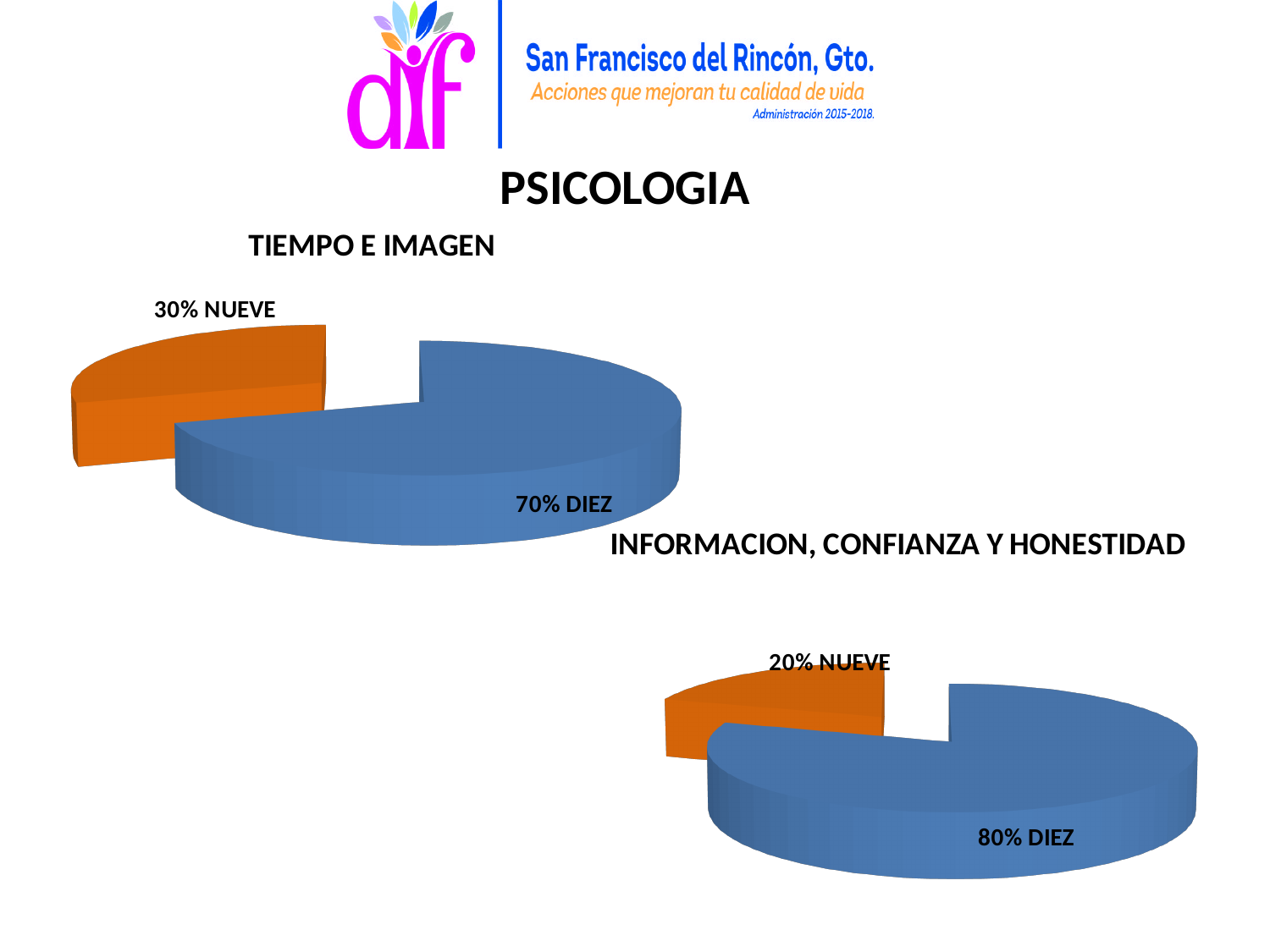
In the 'TIEMPO E IMAGEN' chart, what share of the pie is labelled DIEZ? 70% In the 'INFORMACION, CONFIANZA Y HONESTIDAD' chart, what share of the pie is labelled NUEVE? 20% In the 'INFORMACION, CONFIANZA Y HONESTIDAD' chart, which slice is the smallest? NUEVE How many slices does the 'INFORMACION, CONFIANZA Y HONESTIDAD' chart have? 2 In the 'INFORMACION, CONFIANZA Y HONESTIDAD' chart, what share of the pie is labelled DIEZ? 80% In the 'TIEMPO E IMAGEN' chart, what is the difference in percentage points between the DIEZ and NUEVE slices? 40 In the 'INFORMACION, CONFIANZA Y HONESTIDAD' chart, what is the difference in percentage points between the DIEZ and NUEVE slices? 60 In the 'TIEMPO E IMAGEN' chart, which slice is the largest? DIEZ In the 'TIEMPO E IMAGEN' chart, what colour is the NUEVE slice? Orange Which chart has the larger NUEVE share, 'TIEMPO E IMAGEN' or 'INFORMACION, CONFIANZA Y HONESTIDAD'? TIEMPO E IMAGEN What kind of chart is the 'TIEMPO E IMAGEN' chart? Pie chart